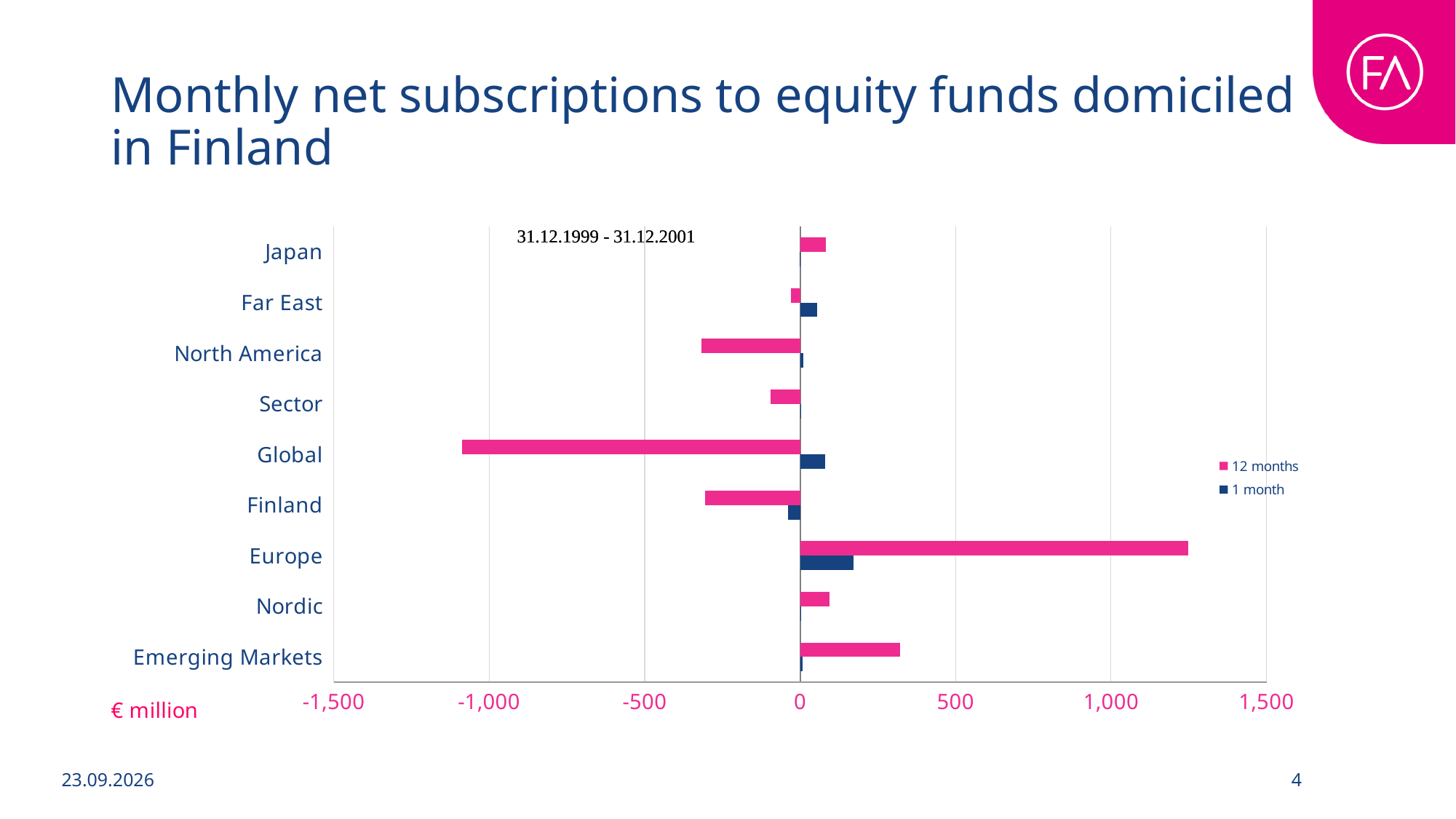
Which category has the highest 1 month value? Europe Is the 12 months value for North America greater or less than -500? greater Is the 12 months value for Global greater or less than -1,000? less How many series does the chart legend list? 2 What unit is shown below the horizontal axis of the chart? € million What kind of chart is shown on the slide? bar chart What period is stated in the text label inside the chart? 31.12.1999 - 31.12.2001 Which category has the highest 12 months value? Europe Is the 12 months value for Europe greater or less than 1,000? greater Which category has the lowest 12 months value? Global How many categories are shown on the vertical axis of the chart? 9 Which is larger, the 12 months value for Emerging Markets or the 12 months value for Nordic? Emerging Markets